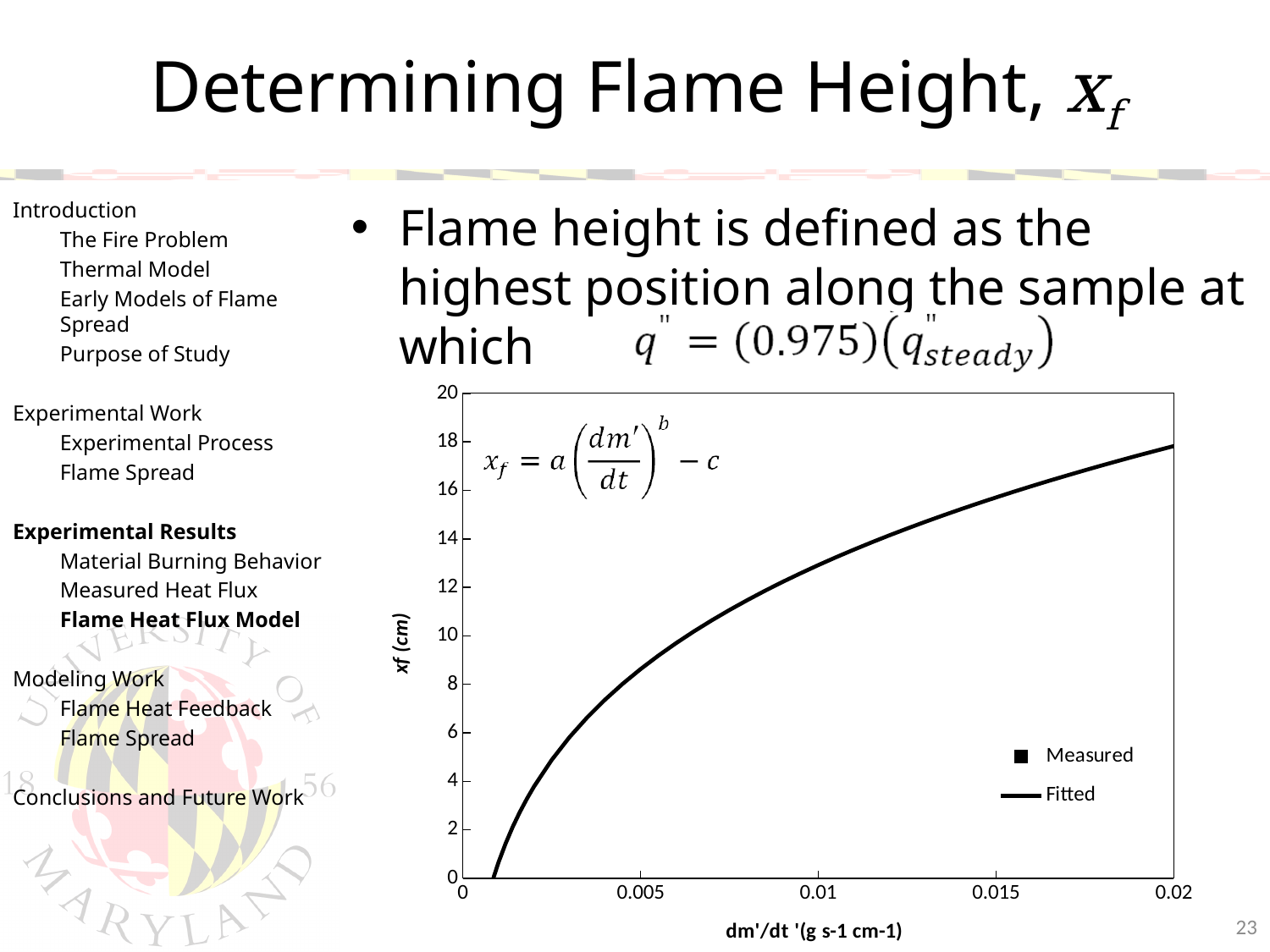
Is the Fitted value of xf at dm'/dt = 0.01 greater or less than 10? greater Is the Fitted value of xf at dm'/dt = 0.02 greater or less than 16? greater What is the label on the chart's y axis? xf (cm) Is the Fitted value of xf larger at dm'/dt = 0.015 or at dm'/dt = 0.005? 0.015 Is the Fitted value of xf at dm'/dt = 0.005 greater or less than 10? less What is the highest value shown on the chart's y axis? 20 Does the Fitted curve rise or fall as dm'/dt increases along the x axis? rises What are the two entries in the chart's legend? Measured and Fitted How many series does the chart's legend list? 2 What kind of chart is shown on the slide? line chart